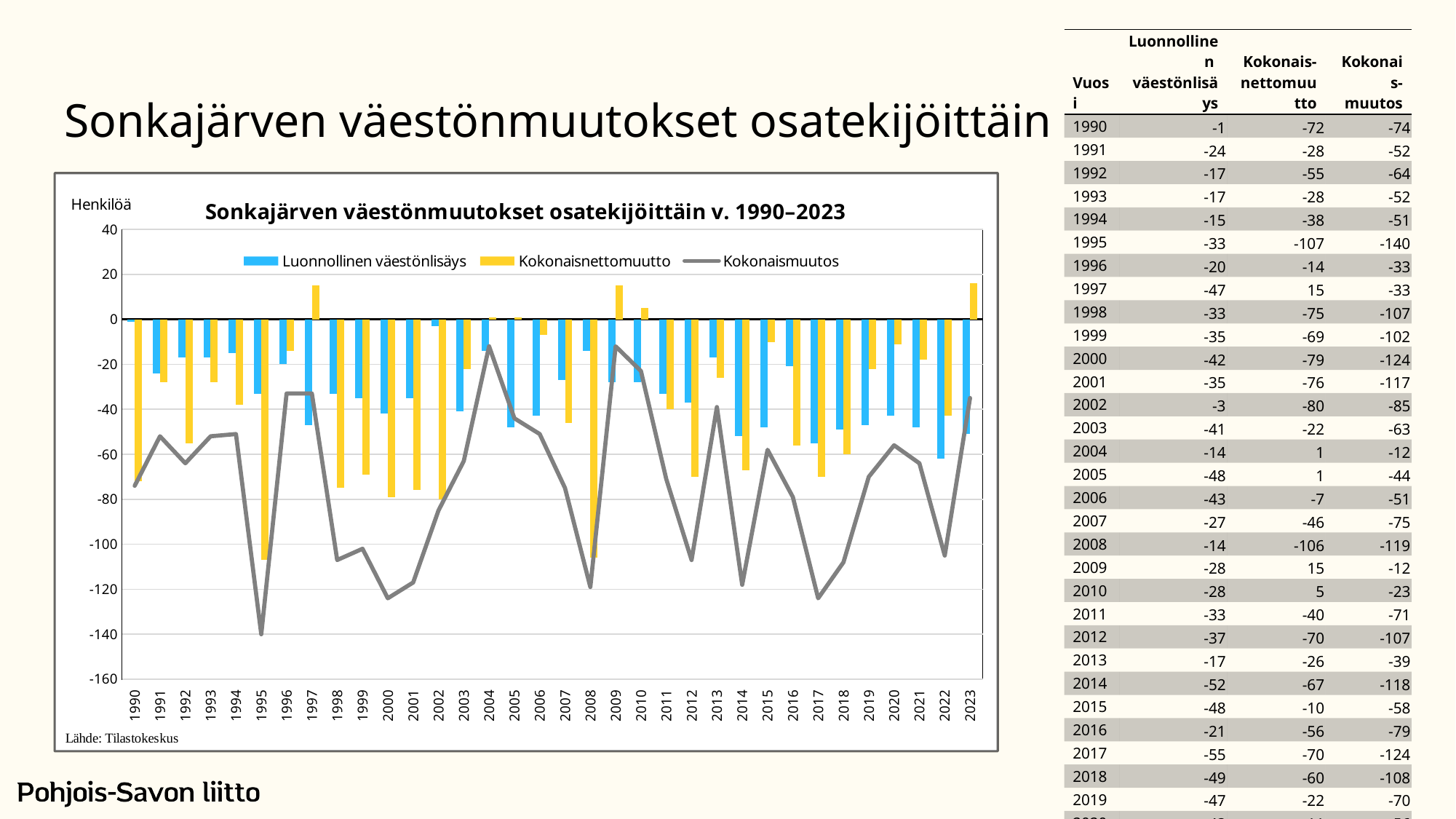
How many series does the chart legend list? 3 What is the Kokonaismuutos value for 1995? -140 Which year has the larger Kokonaismuutos value, 2008 or 2009? 2009 What is the Luonnollinen väestönlisäys value for 2002? -3 How many years are shown on the x axis of the chart? 34 What is the Kokonaisnettomuutto value for 1997? 15 What kind of chart is used for the Luonnollinen väestönlisäys and Kokonaisnettomuutto series? bar chart In which year is the Kokonaismuutos line at its lowest? 1995 What is the difference between the Kokonaismuutos values for 1995 and 1996? 107 Does the Kokonaismuutos line rise or fall from 1994 to 1995? fall Is the Kokonaismuutos value for 2000 greater or less than -100? less Which series in the chart is drawn as a line rather than bars? Kokonaismuutos